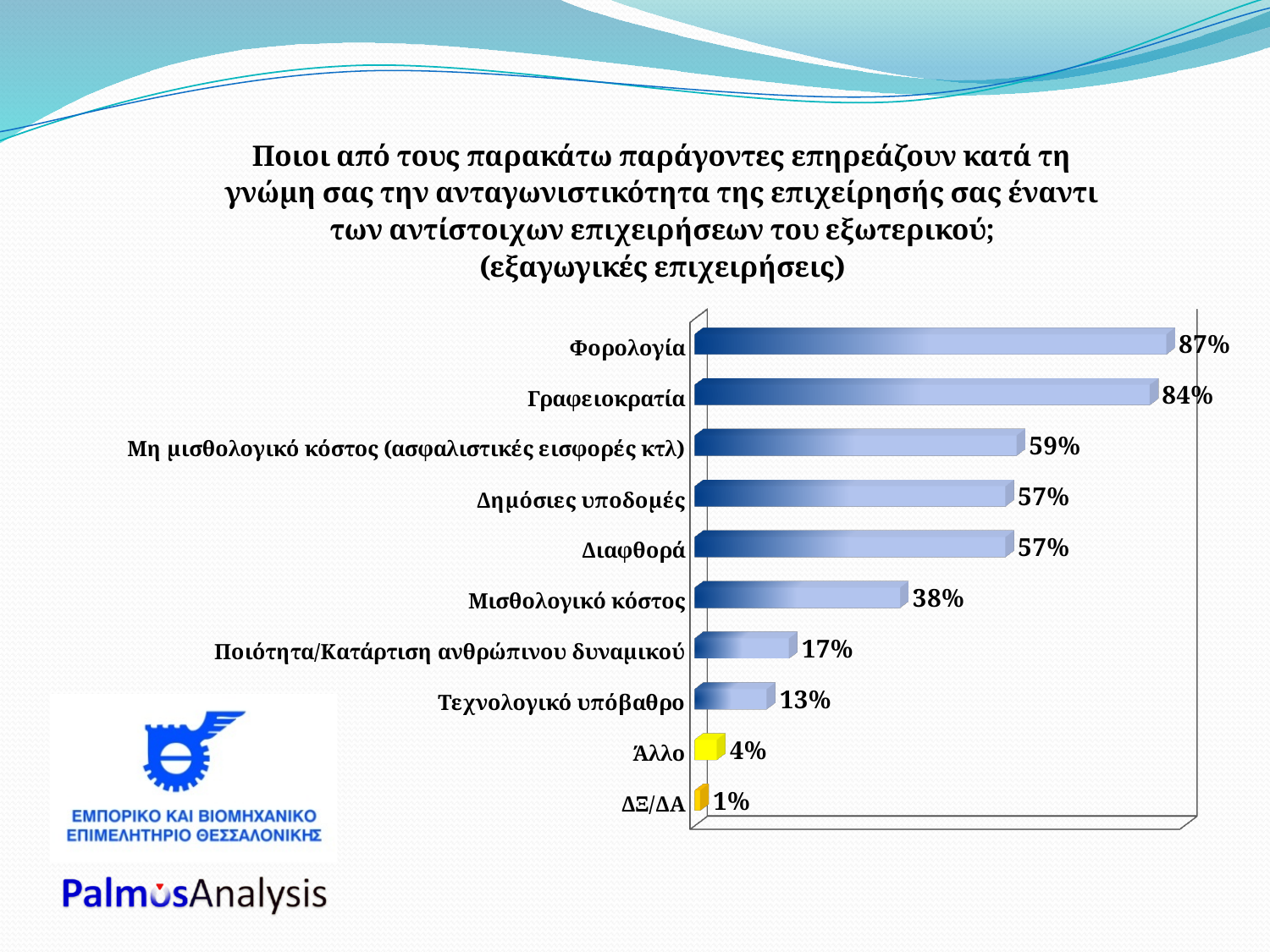
How many categories are shown in the chart? 10 What is the difference between the values for Μη μισθολογικό κόστος (ασφαλιστικές εισφορές κτλ) and Μισθολογικό κόστος? 21% What is the value for Άλλο? 4% Which two categories share the same value of 57%? Δημόσιες υποδομές and Διαφθορά What is the value for Φορολογία? 87% What kind of chart is shown on the slide? Bar chart Which is larger, the value for Ποιότητα/Κατάρτιση ανθρώπινου δυναμικού or the value for Τεχνολογικό υπόβαθρο? Ποιότητα/Κατάρτιση ανθρώπινου δυναμικού What is the difference between the values for Φορολογία and Γραφειοκρατία? 3% What is the value for Μισθολογικό κόστος? 38% What is the value for Τεχνολογικό υπόβαθρο? 13% Which category has the lowest value? ΔΞ/ΔΑ Which category has the highest value? Φορολογία